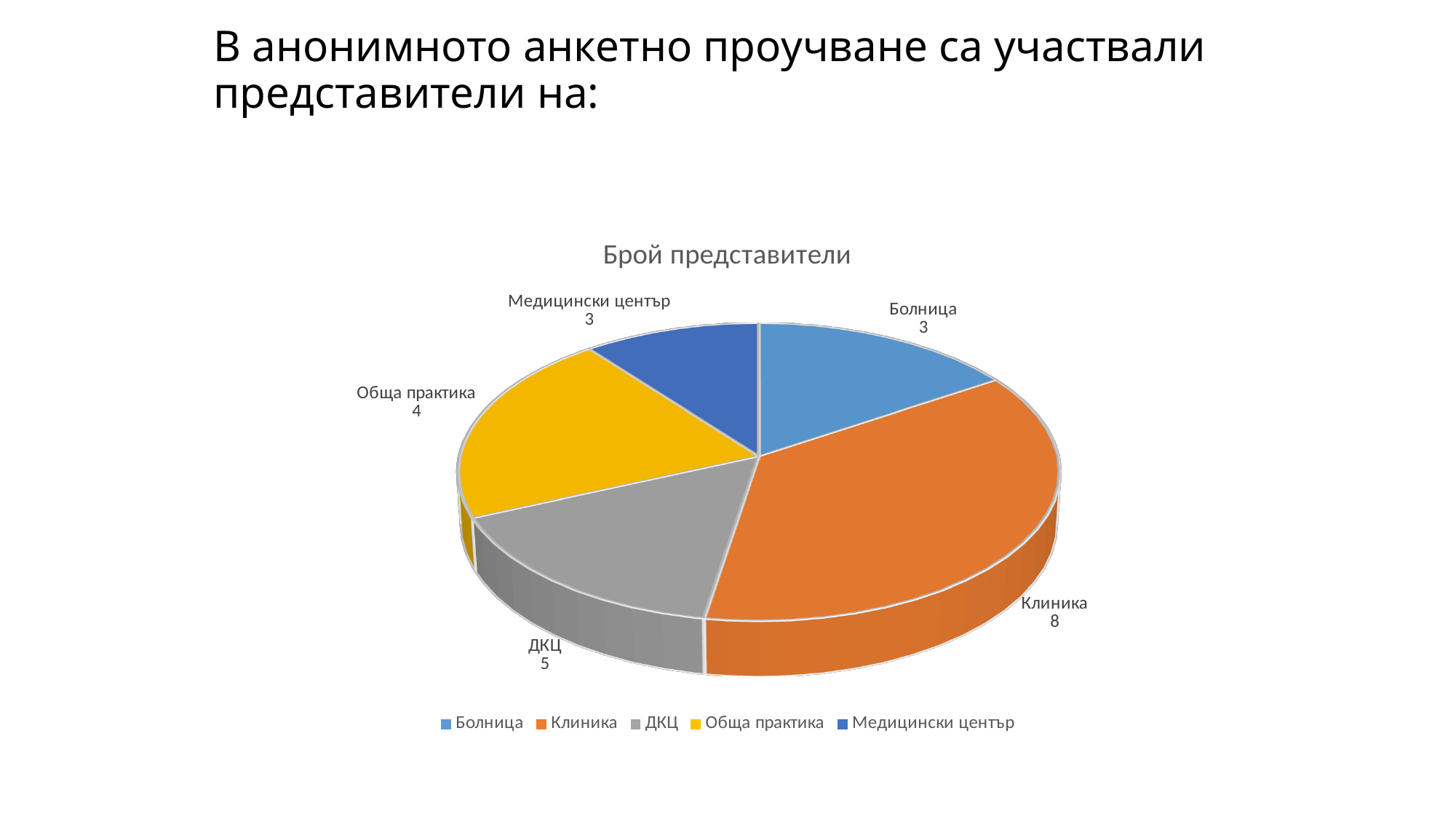
How many entries does the legend list? 5 Which is larger, the value for Обща практика or the value for Медицински център? Обща практика What is the value for ДКЦ? 5 What is the total of all slices in the pie chart? 23 How many categories does the pie chart have? 5 What is the title of the chart? Брой представители What is the difference between the values for Клиника and ДКЦ? 3 What is the value for Болница? 3 How many representatives are from Клиника? 8 What is the value for Обща практика? 4 Which category has the largest slice of the pie? Клиника What kind of chart is shown on the slide? Pie chart